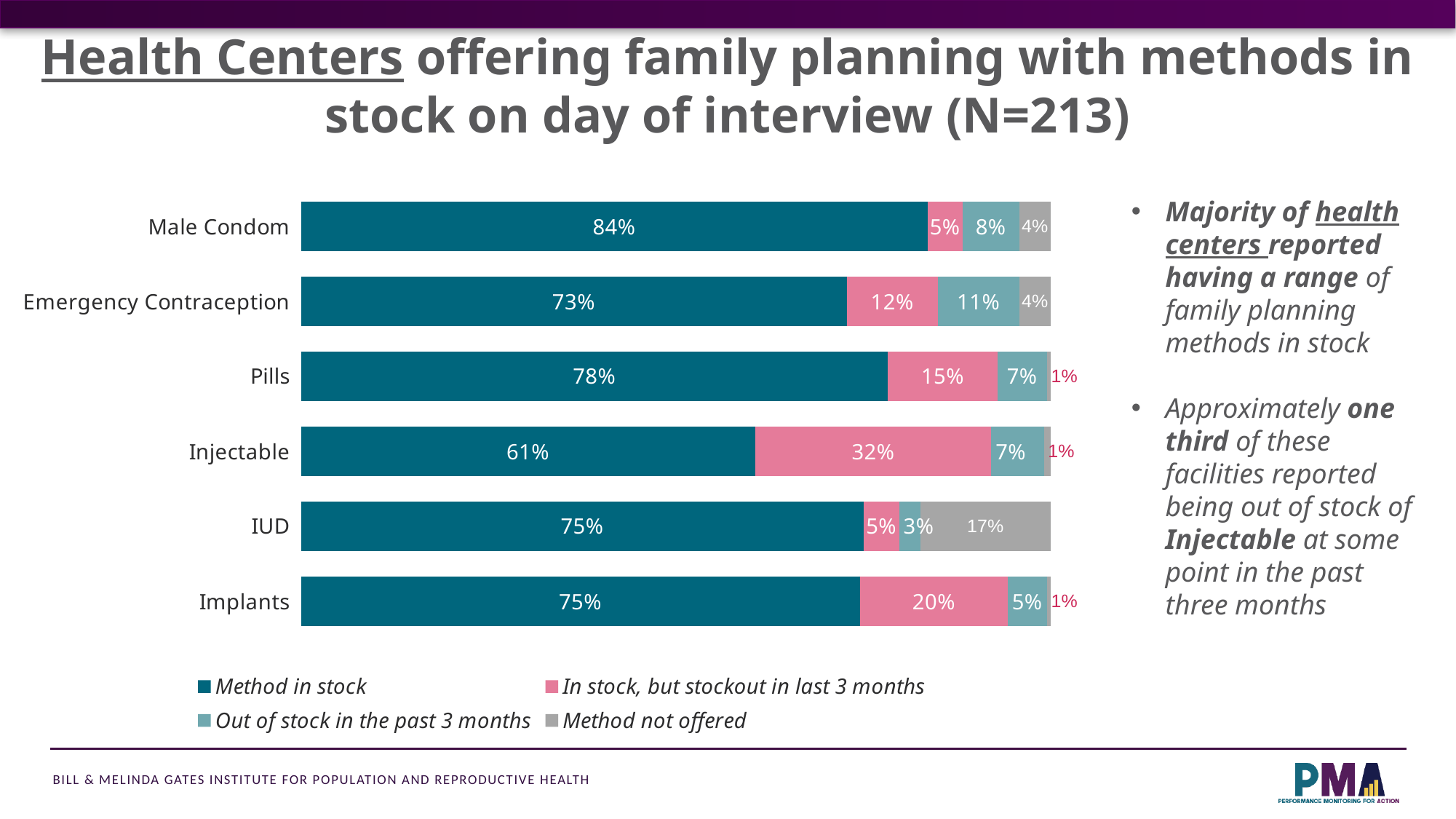
How many series does the legend list? 4 What is the 'In stock, but stockout in last 3 months' value for Implants? 20% What percentage of health centers reported Injectable as 'Method in stock'? 61% What is the 'Method not offered' value for IUD? 17% Which has a higher 'Method in stock' percentage, Pills or Emergency Contraception? Pills What is the 'Out of stock in the past 3 months' value for Emergency Contraception? 11% What type of chart is shown on the slide? Stacked bar chart Which method has the highest 'Method in stock' percentage? Male Condom What is the difference in 'Method in stock' percentage between Male Condom and Injectable? 23 percentage points Which method has the highest 'In stock, but stockout in last 3 months' percentage? Injectable Which method has the lowest 'Method in stock' percentage? Injectable How many family planning methods are shown in the chart? 6